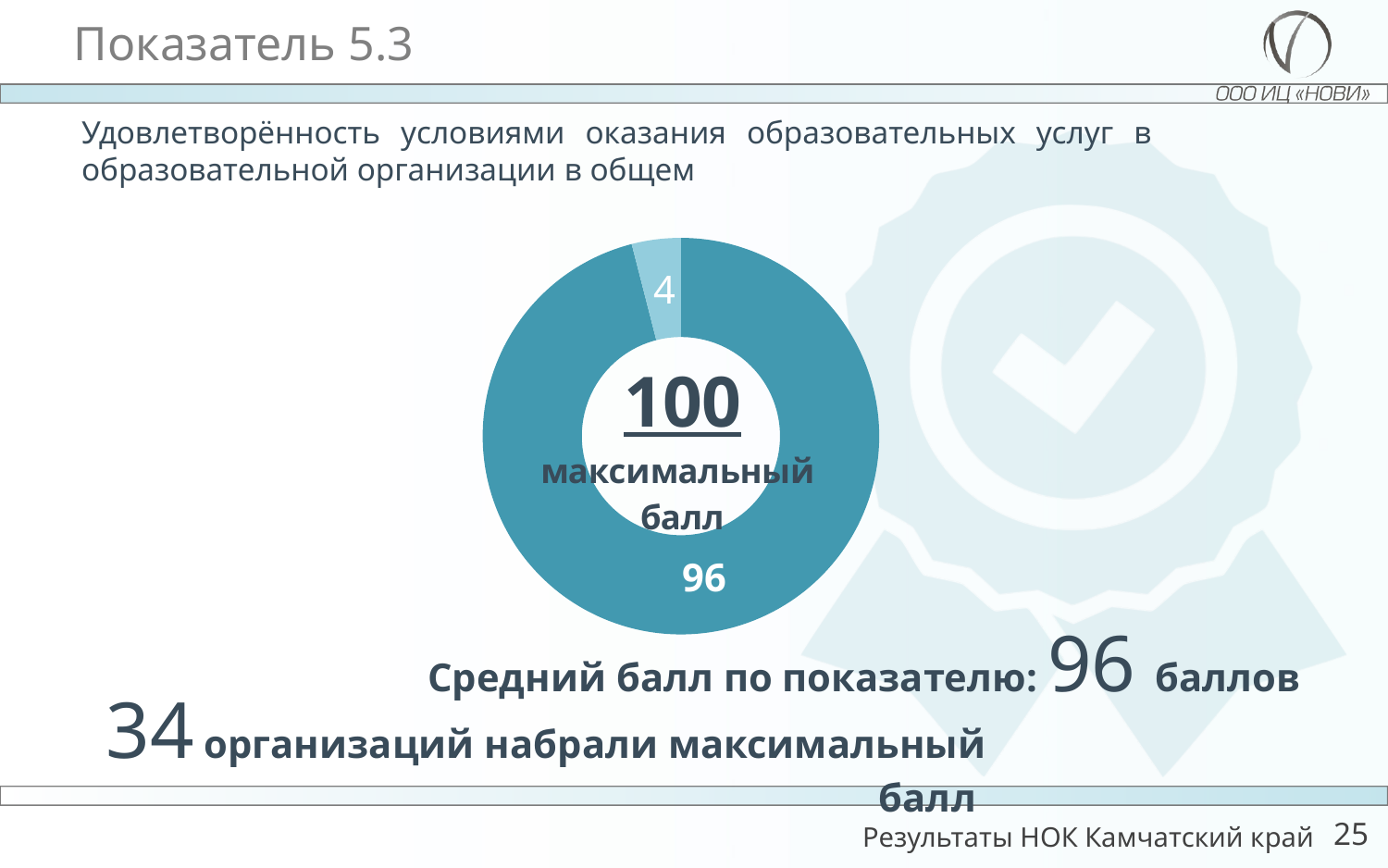
What is the smallest value shown on the donut chart? 4 What share of the donut chart does the slice labelled 96 represent? 96% What text appears below the number in the centre of the donut chart? максимальный балл What is the difference between the two slice values on the donut chart? 92 What value is printed on the large dark teal slice of the donut chart? 96 How many slices does the donut chart have? 2 What is the largest value shown on the donut chart? 96 Which slice of the donut chart is larger, the dark teal one or the light teal one? the dark teal one What number is printed in the centre of the donut chart? 100 What is the total of the two slice values on the donut chart? 100 What kind of chart is shown on the slide? pie chart (donut) What value is printed on the small light teal slice of the donut chart? 4